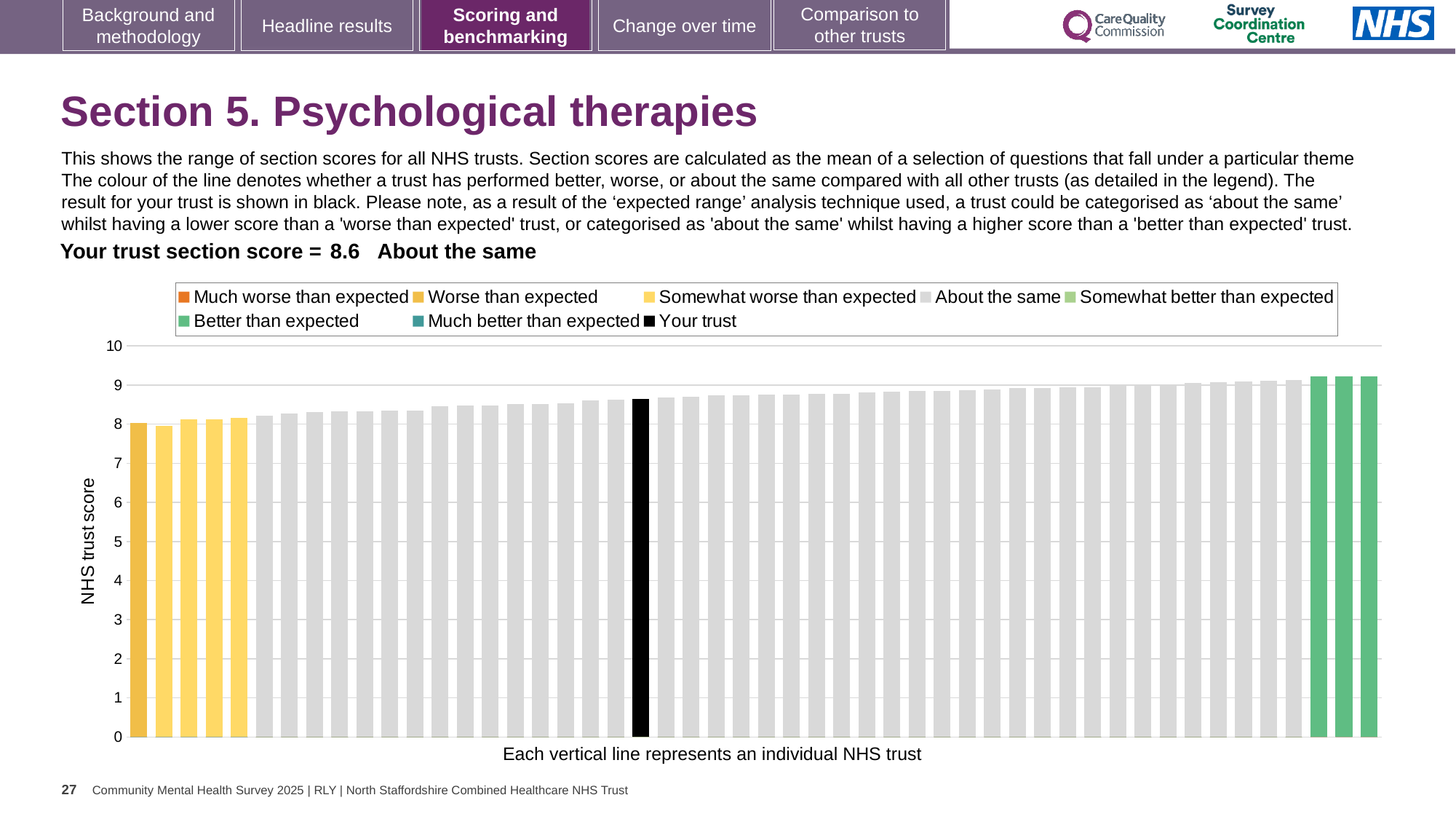
How many green 'Better than expected' bars are shown in the chart? 3 Is the value for your trust (the black bar) greater or less than 9? less Do the bar values rise or fall from left to right along the x axis? rise What colour is the bar representing your trust? black What is the section score for your trust shown on the slide? 8.6 Is the value for your trust (the black bar) greater or less than 8? greater What is the label on the vertical axis of the chart? NHS trust score Which category is your trust's section score placed in? About the same How many entries does the chart legend list? 8 What kind of chart is shown on the slide? bar chart Is the value of the lowest bar greater or less than 7? greater